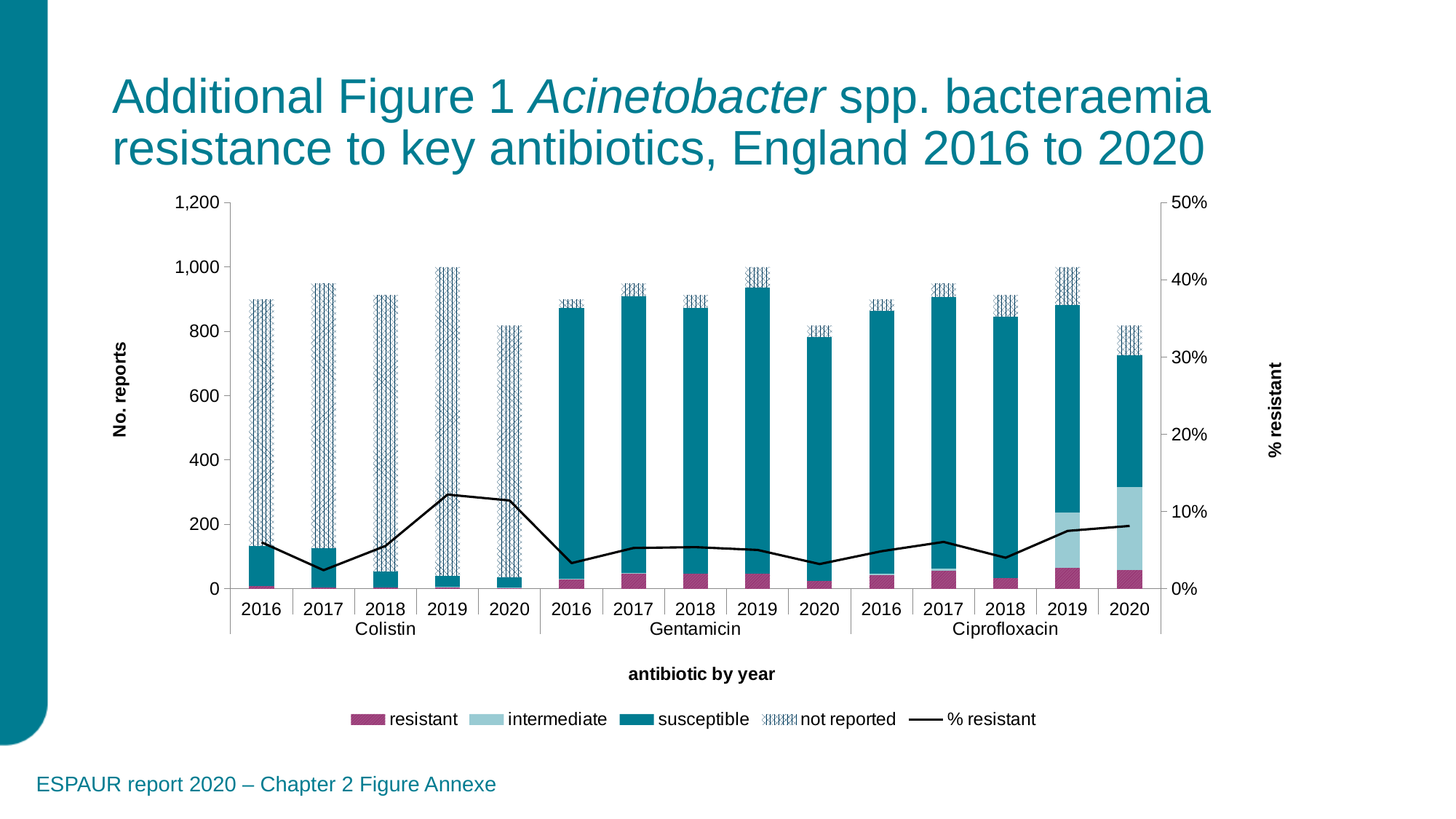
Which is larger, the intermediate segment for Ciprofloxacin 2019 or for Ciprofloxacin 2020? Ciprofloxacin 2020 How many bars are plotted in the chart? 15 How many antibiotics are shown along the x axis? 3 Is the top of the intermediate segment for Ciprofloxacin 2019 greater or less than 200 reports? greater What kind of chart is shown on the slide? Stacked bar chart with a line What is the title of the right vertical axis? % resistant Is the % resistant value for Colistin 2019 greater or less than 10%? greater Is the top of the susceptible segment for Gentamicin 2020 greater or less than 800 reports? less What is the title of the left vertical axis? No. reports Does the % resistant line rise or fall for Ciprofloxacin from 2018 to 2020? rise How many series does the legend list? 5